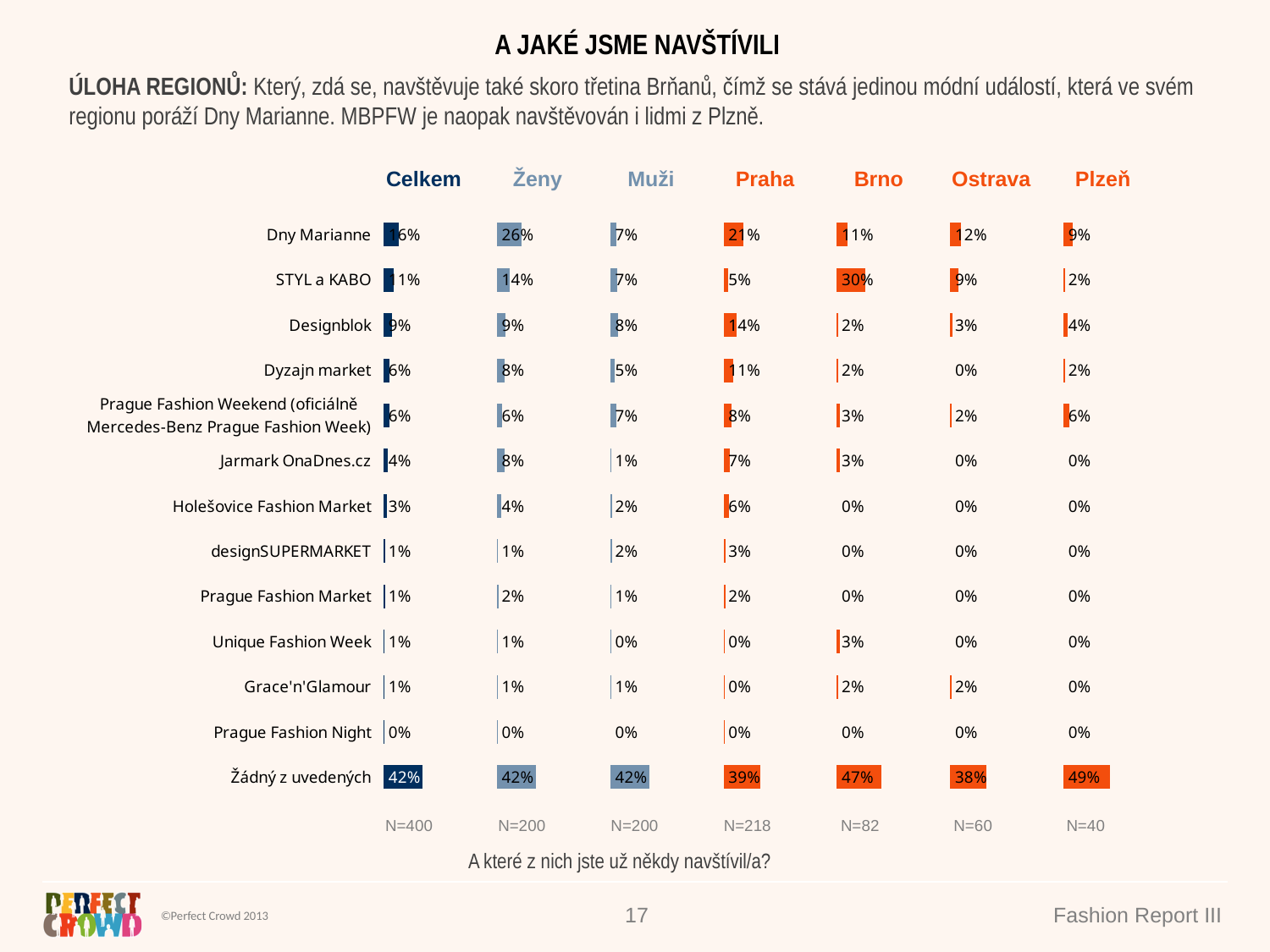
In the Plzeň column, what is the value for Žádný z uvedených? 49% In the Praha column, what is the value for Designblok? 14% In the Brno column, which event (excluding Žádný z uvedených) has the highest value? STYL a KABO In the Praha column, which event (excluding Žádný z uvedených) has the highest value? Dny Marianne What is the sample size (N) shown for the Brno column? N=82 In the Brno column, what is the value for STYL a KABO? 30% Across the regional columns (Praha, Brno, Ostrava, Plzeň), which region has the lowest value for Žádný z uvedených? Ostrava What type of chart is used to display the values on this slide? Bar chart What is the difference between the Ženy and Muži values for Dny Marianne? 19% Which is larger: the Praha value for Dyzajn market or the Brno value for Dyzajn market? Praha How many columns (groups) are shown in the chart? 7 In the Ženy column, what percentage of respondents visited Dny Marianne? 26%